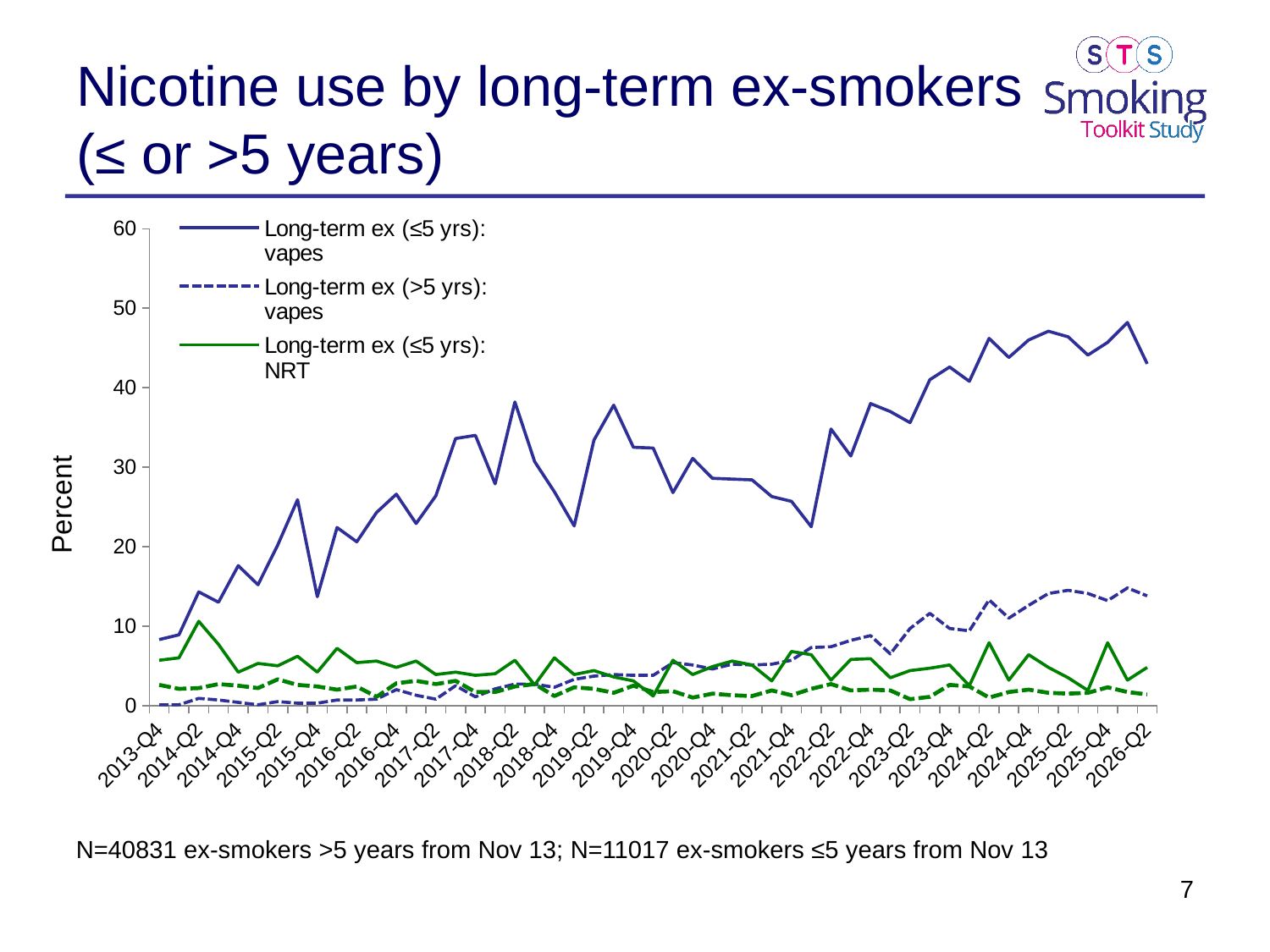
Is the value for Long-term ex (≤5 yrs): vapes at 2026-Q2 greater or less than 40? greater Is the value for Long-term ex (≤5 yrs): NRT at 2014-Q2 greater or less than 20? less What is the label on the y axis of the chart? Percent Is the value for Long-term ex (>5 yrs): vapes at 2026-Q2 greater or less than 20? less What is the first x-axis label on the chart? 2013-Q4 Which series reaches the highest value on the chart? Long-term ex (≤5 yrs): vapes How many series does the chart legend list? 3 At 2024-Q2, which is larger: Long-term ex (≤5 yrs): vapes or Long-term ex (≤5 yrs): NRT? Long-term ex (≤5 yrs): vapes Does the Long-term ex (≤5 yrs): vapes series generally rise or fall from 2013-Q4 to 2026-Q2? rise At 2026-Q2, which is larger: Long-term ex (≤5 yrs): vapes or Long-term ex (>5 yrs): vapes? Long-term ex (≤5 yrs): vapes What kind of chart is shown on the slide? line chart